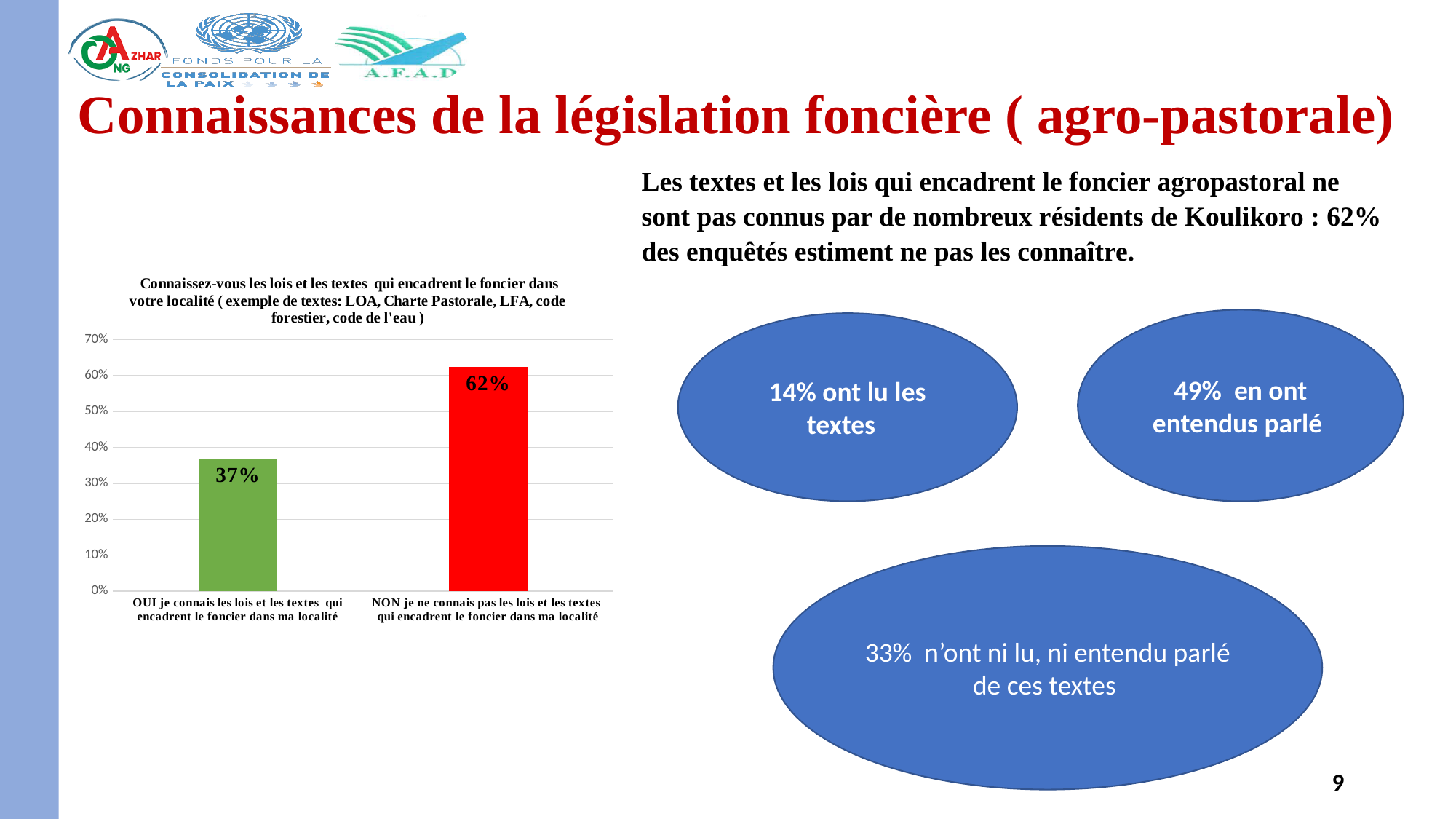
What is the highest value shown on the chart's vertical axis? 70% Which category has the lowest value in the chart? OUI je connais les lois et les textes qui encadrent le foncier dans ma localité Is the value for the OUI bar greater or less than 40%? less Is the value for the NON bar greater or less than 50%? greater Which category has the highest value in the chart? NON je ne connais pas les lois et les textes qui encadrent le foncier dans ma localité What is the value for the 'NON je ne connais pas les lois et les textes qui encadrent le foncier dans ma localité' bar? 62% What is the difference between the NON bar and the OUI bar? 25% What is the value for the 'OUI je connais les lois et les textes qui encadrent le foncier dans ma localité' bar? 37% What colour is the NON bar? red What kind of chart is shown on the slide? bar chart How many categories are shown in the chart? 2 Which is larger, the OUI bar or the NON bar? NON